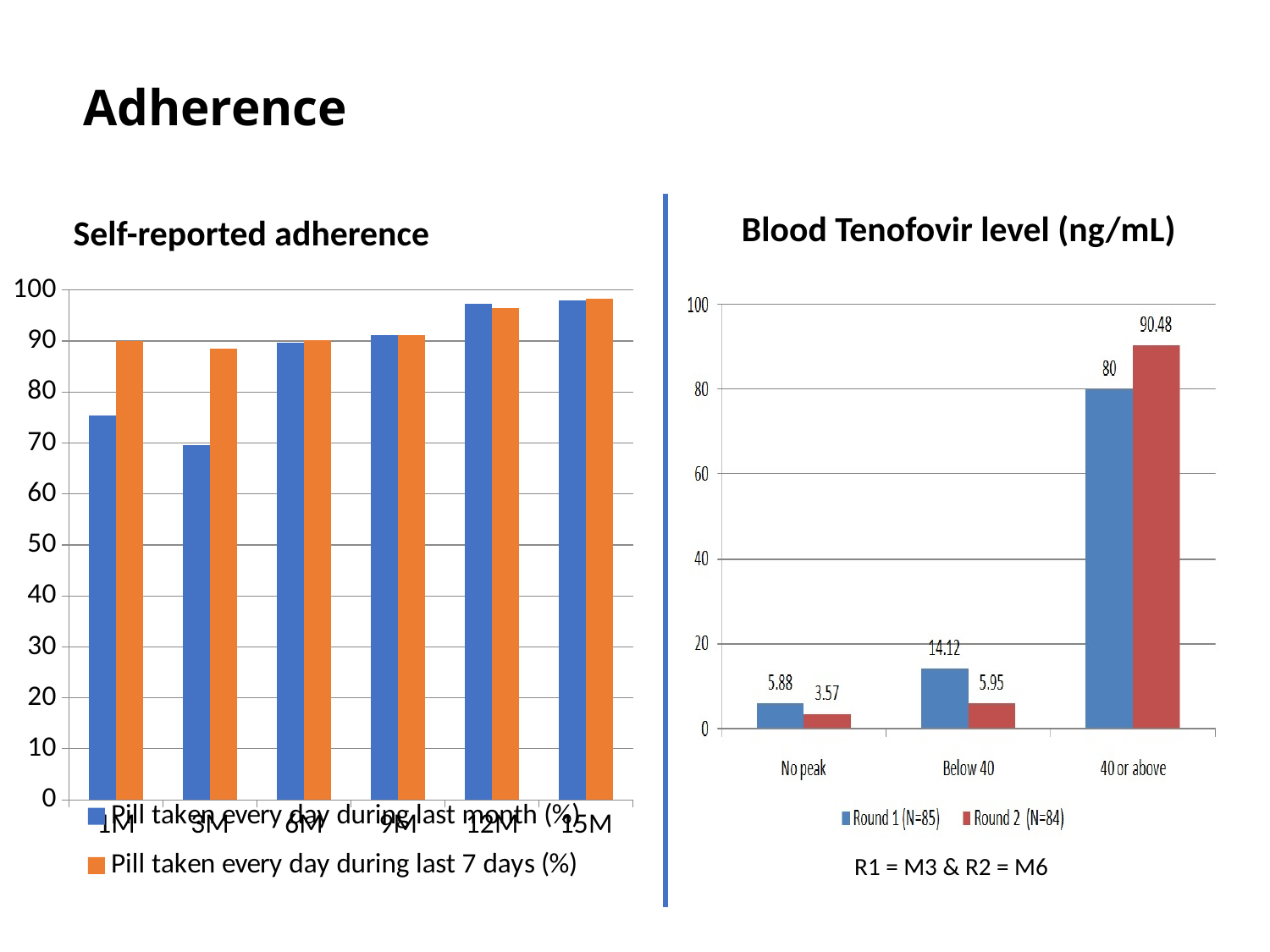
What kind of chart is the Self-reported adherence chart? Bar chart In the Self-reported adherence chart, how many time-point categories are shown on the x axis? 6 In the Blood Tenofovir level (ng/mL) chart, what is the value for Round 1 (N=85) in the 'Below 40' category? 14.12 In the Blood Tenofovir level (ng/mL) chart, which category has the highest value for Round 1 (N=85)? 40 or above In the Blood Tenofovir level (ng/mL) chart, which category has the lowest value for Round 2 (N=84)? No peak In the Blood Tenofovir level (ng/mL) chart, what is the difference between Round 2 (N=84) and Round 1 (N=85) in the '40 or above' category? 10.48 In the Self-reported adherence chart, which is larger at 1M: 'Pill taken every day during last month (%)' or 'Pill taken every day during last 7 days (%)'? Pill taken every day during last 7 days (%) How many series does the legend of the Blood Tenofovir level (ng/mL) chart list? 2 In the Self-reported adherence chart, is the value for 'Pill taken every day during last month (%)' at 3M greater or less than 80? less In the Blood Tenofovir level (ng/mL) chart, what is the value for Round 2 (N=84) in the '40 or above' category? 90.48 In the Blood Tenofovir level (ng/mL) chart, what is the value for Round 2 (N=84) in the 'No peak' category? 3.57 In the Blood Tenofovir level (ng/mL) chart, which is larger in the 'Below 40' category: Round 1 (N=85) or Round 2 (N=84)? Round 1 (N=85)